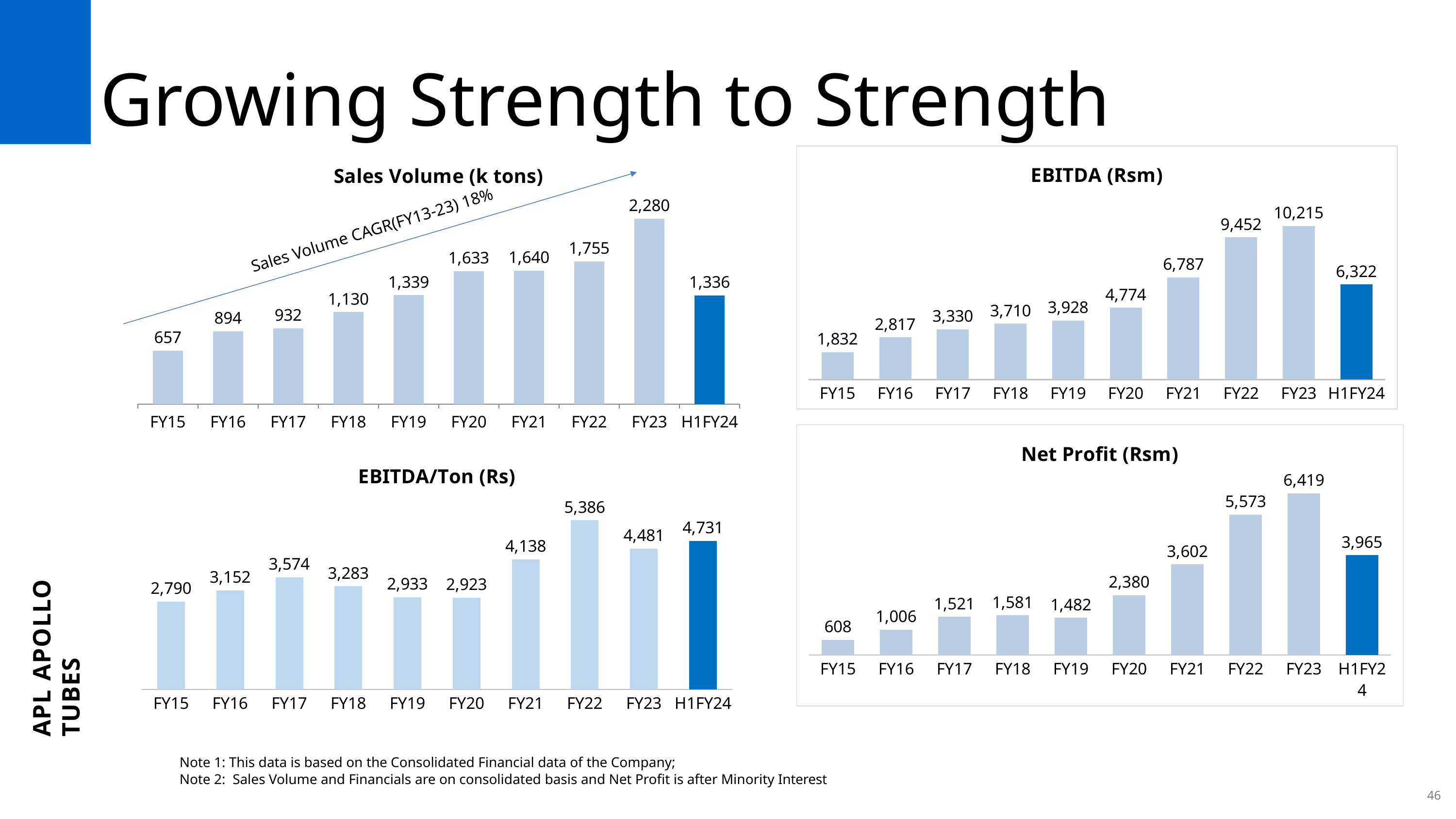
In the Sales Volume (k tons) chart, which category has the highest value? FY23 In the Sales Volume (k tons) chart, what is the value for FY19? 1,339 In the Net Profit (Rsm) chart, what is the value for FY20? 2,380 In the EBITDA/Ton (Rs) chart, what is the difference between H1FY24 and FY23? 250 In the Net Profit (Rsm) chart, which category has the highest value? FY23 In the EBITDA (Rsm) chart, how many categories are shown on the x axis? 10 What kind of chart is the Net Profit (Rsm) chart? Bar chart In the EBITDA (Rsm) chart, what is the value for FY21? 6,787 In the EBITDA/Ton (Rs) chart, what is the value for FY22? 5,386 In the Sales Volume (k tons) chart, what is the difference between FY23 and FY22? 525 In the EBITDA (Rsm) chart, which category has the lowest value? FY15 In the EBITDA/Ton (Rs) chart, which is larger, FY17 or FY18? FY17